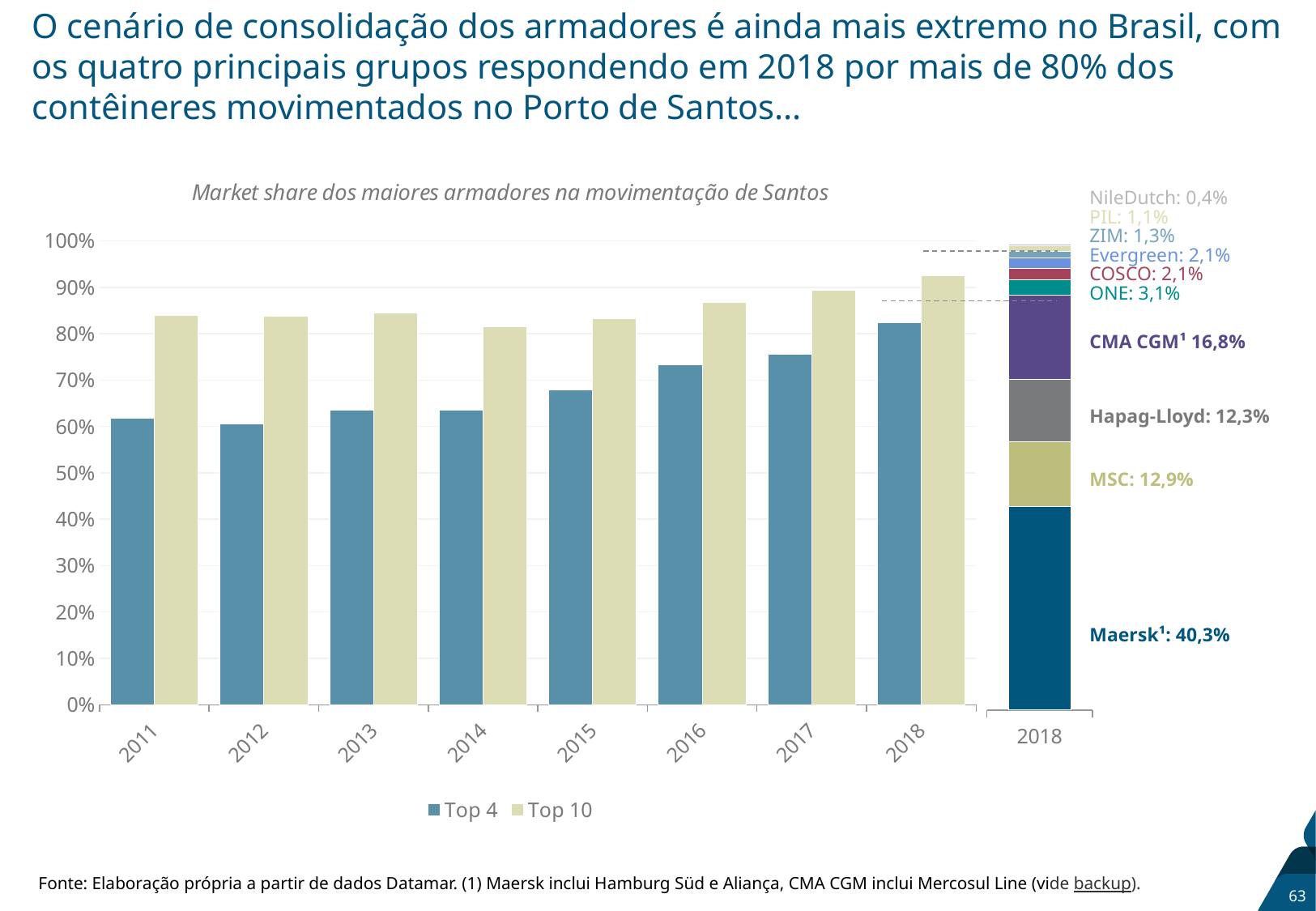
In the grouped bar chart, is the Top 4 value for 2018 greater or less than 80%? greater In the stacked 2018 bar, what is Hapag-Lloyd's market share? 12,3% In the stacked 2018 bar, which carrier has the largest market share? Maersk In the stacked 2018 bar, what is the market share of CMA CGM? 16,8% In the grouped bar chart, is the Top 4 value for 2014 greater or less than 70%? less How many years are shown on the x axis of the grouped bar chart? 8 In the stacked 2018 bar, what is Maersk's market share? 40,3% In the stacked 2018 bar, what is the combined market share of Maersk, MSC, Hapag-Lloyd and CMA CGM? 82,3% In the stacked 2018 bar, what is the difference between Maersk's and MSC's market shares? 27,4% How many series does the legend of the grouped bar chart list? 2 In the stacked 2018 bar, which carrier has the smallest market share? NileDutch In the stacked 2018 bar, which has the larger market share, MSC or Hapag-Lloyd? MSC